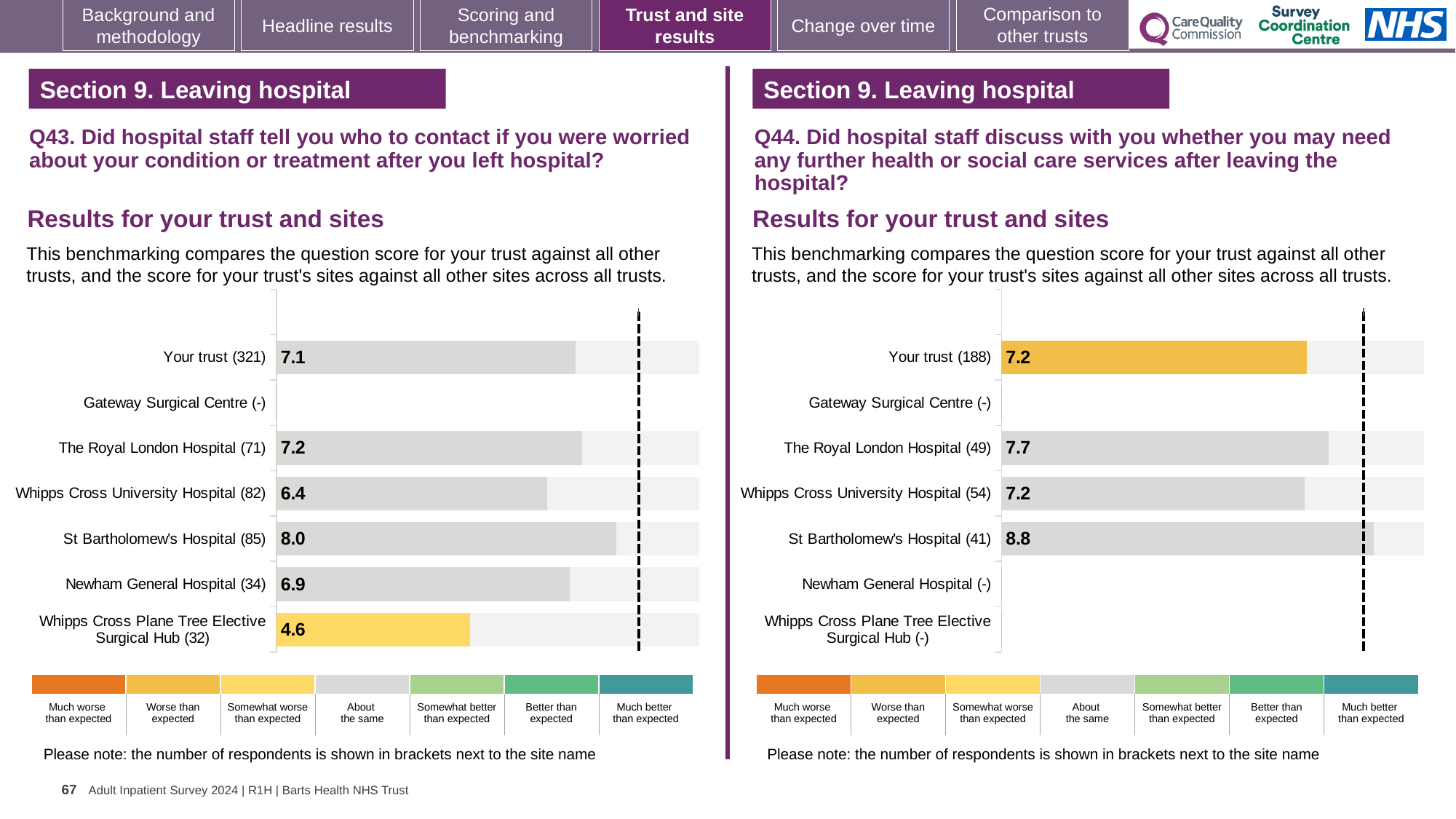
In the Q43 chart on the left, what is the difference between the scores for St Bartholomew's Hospital and Whipps Cross University Hospital? 1.6 What type of chart is used for the Q43 results on the left? Bar chart In the Q44 chart on the right, which site has the highest score? St Bartholomew's Hospital In the Q43 chart on the left, which site has the lowest score? Whipps Cross Plane Tree Elective Surgical Hub In the Q44 chart on the right, how many rows show a numeric score? 4 In the Q43 chart on the left, what is the score for Your trust? 7.1 In the Q44 chart on the right, what is the score for The Royal London Hospital? 7.7 In the Q43 chart on the left, what is the score for Whipps Cross Plane Tree Elective Surgical Hub? 4.6 In the Q44 chart on the right, what is the difference between the scores for St Bartholomew's Hospital and Your trust? 1.6 In the Q44 chart on the right, what is the score for St Bartholomew's Hospital? 8.8 In the Q43 chart on the left, which has the higher score: The Royal London Hospital or Newham General Hospital? The Royal London Hospital In the Q43 chart on the left, which site has the highest score? St Bartholomew's Hospital